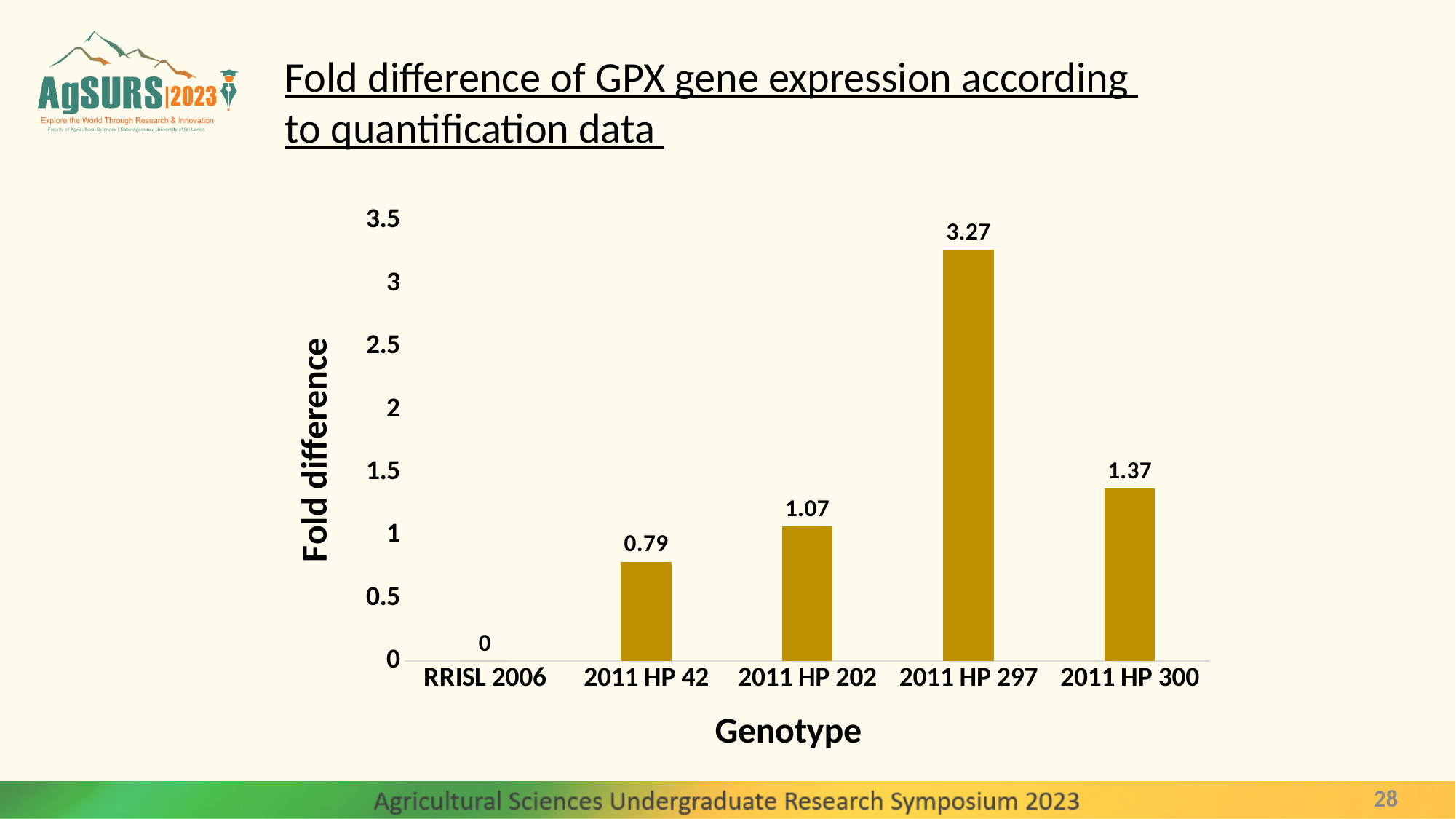
What is the label of the y axis? Fold difference What kind of chart is shown on the slide? Bar chart Which genotype has the highest fold difference? 2011 HP 297 What is the fold difference for genotype 2011 HP 300? 1.37 What is the fold difference for genotype 2011 HP 297? 3.27 What is the fold difference for genotype 2011 HP 42? 0.79 Which has a larger fold difference, 2011 HP 202 or 2011 HP 42? 2011 HP 202 Which genotype has the lowest fold difference? RRISL 2006 How many genotypes are shown on the x axis? 5 Is the fold difference for 2011 HP 297 greater or less than 3? greater What is the fold difference for genotype RRISL 2006? 0 What is the difference in fold difference between 2011 HP 297 and 2011 HP 300? 1.90